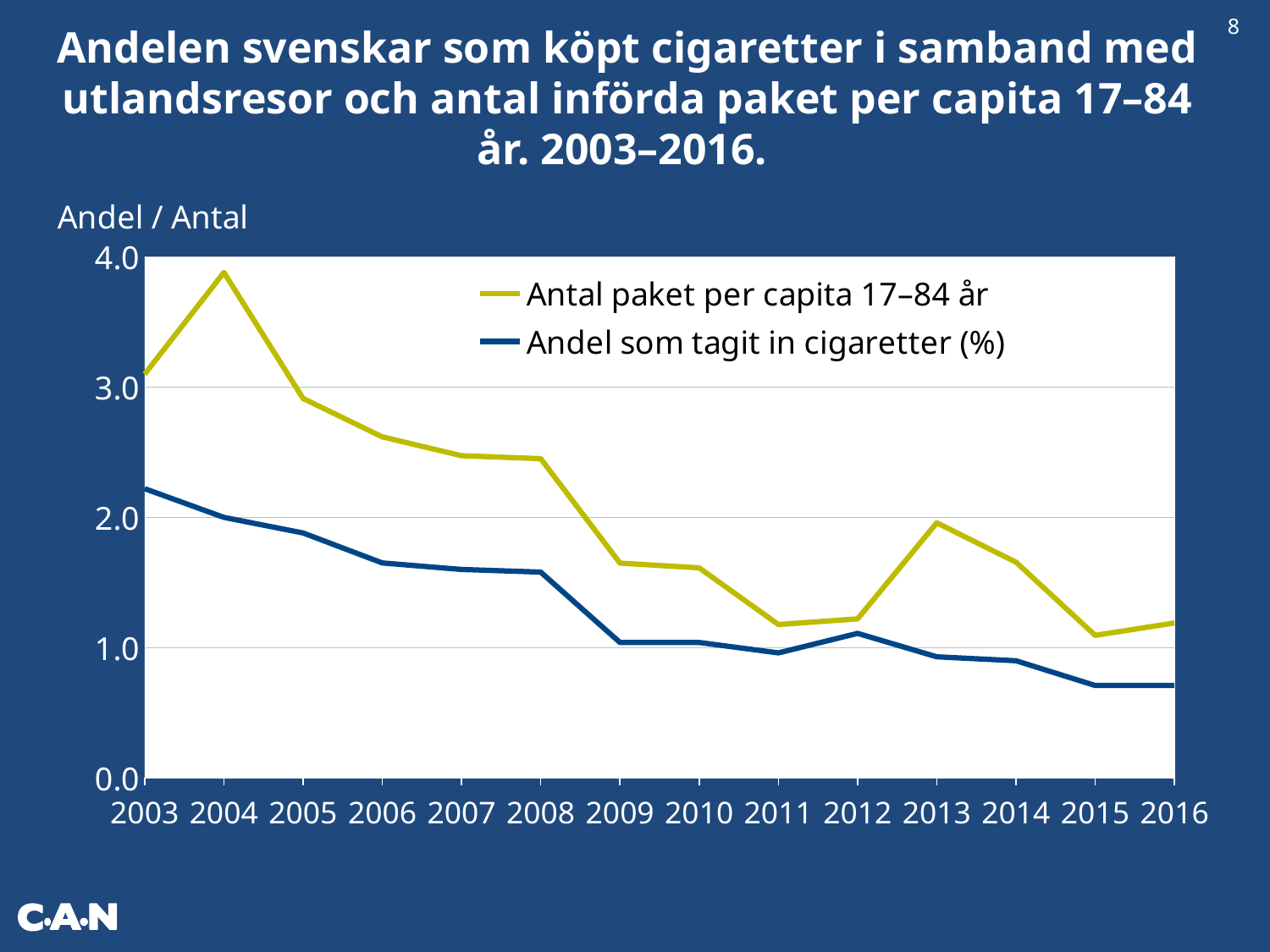
What kind of chart is shown on the slide? Line chart In 2003, which series has the larger value: 'Antal paket per capita 17–84 år' or 'Andel som tagit in cigaretter (%)'? Antal paket per capita 17–84 år Is the value for 'Andel som tagit in cigaretter (%)' in 2003 greater or less than 2.0? greater Is the value for 'Antal paket per capita 17–84 år' in 2009 greater or less than 2.0? less How many years are plotted along the x axis? 14 How many series does the legend list? 2 Which colour is used for the series 'Antal paket per capita 17–84 år'? Yellow In which year does the series 'Andel som tagit in cigaretter (%)' reach its highest value? 2003 In which year does the series 'Antal paket per capita 17–84 år' reach its highest value? 2004 Is the value for 'Antal paket per capita 17–84 år' in 2004 greater or less than 3.0? greater Does the series 'Andel som tagit in cigaretter (%)' generally rise or fall from 2003 to 2016? Fall